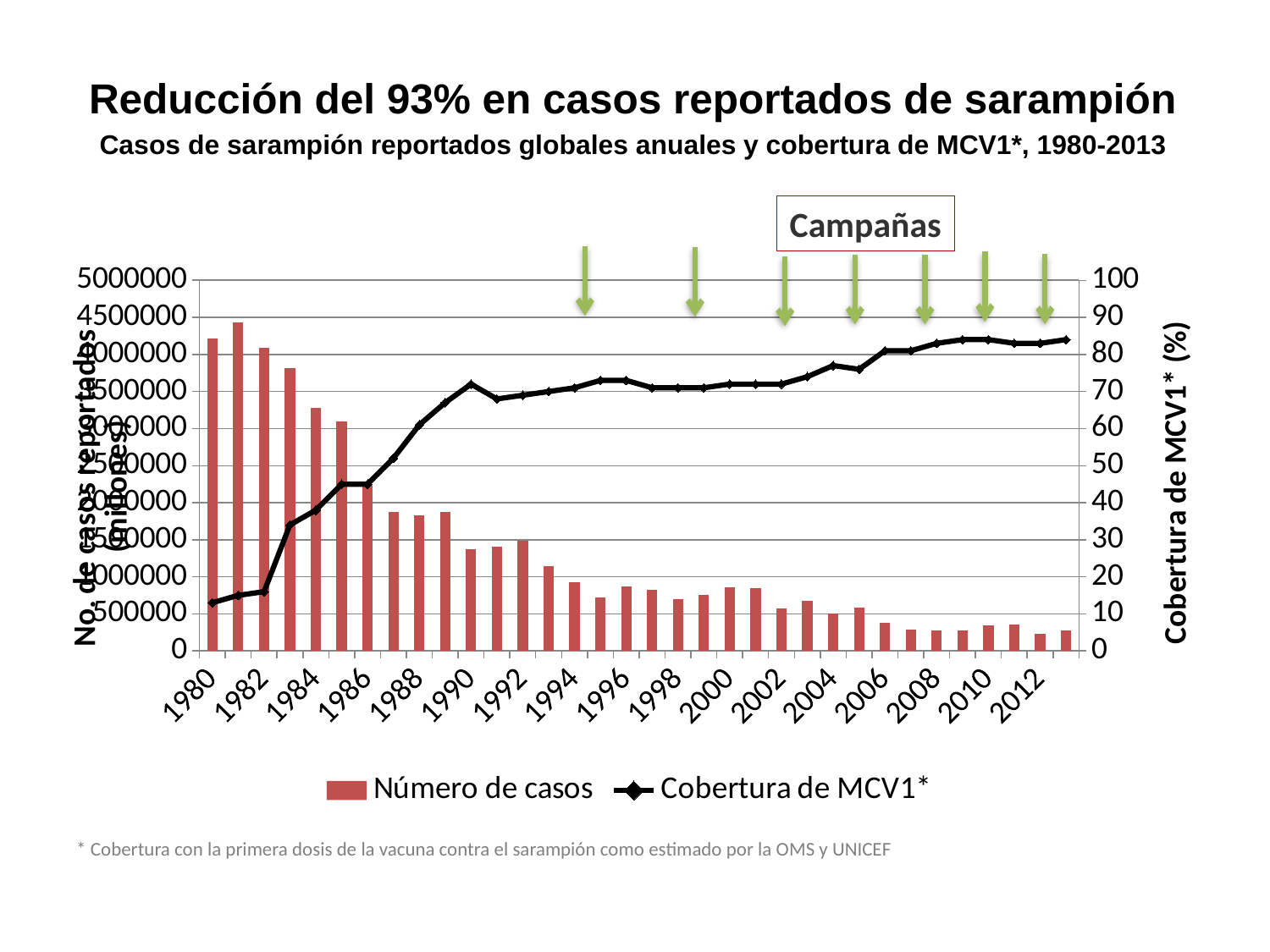
Is the Número de casos value for 1981 greater or less than 4000000? greater What kind of chart is shown on the slide? A combined bar and line chart Which year has a larger Número de casos value, 1980 or 1990? 1980 How many series does the legend list? 2 What are the two series named in the legend? Número de casos and Cobertura de MCV1* Is the Cobertura de MCV1* value for 2013 greater or less than 80? greater What is the title of the chart? Casos de sarampión reportados globales anuales y cobertura de MCV1*, 1980-2013 Is the Número de casos value for 1990 greater or less than 1500000? less In which year is the Número de casos bar highest? 1981 Does the Cobertura de MCV1* line generally rise or fall from 1980 to 2013? rise Do the Número de casos bars generally rise or fall from 1980 to 2013? fall